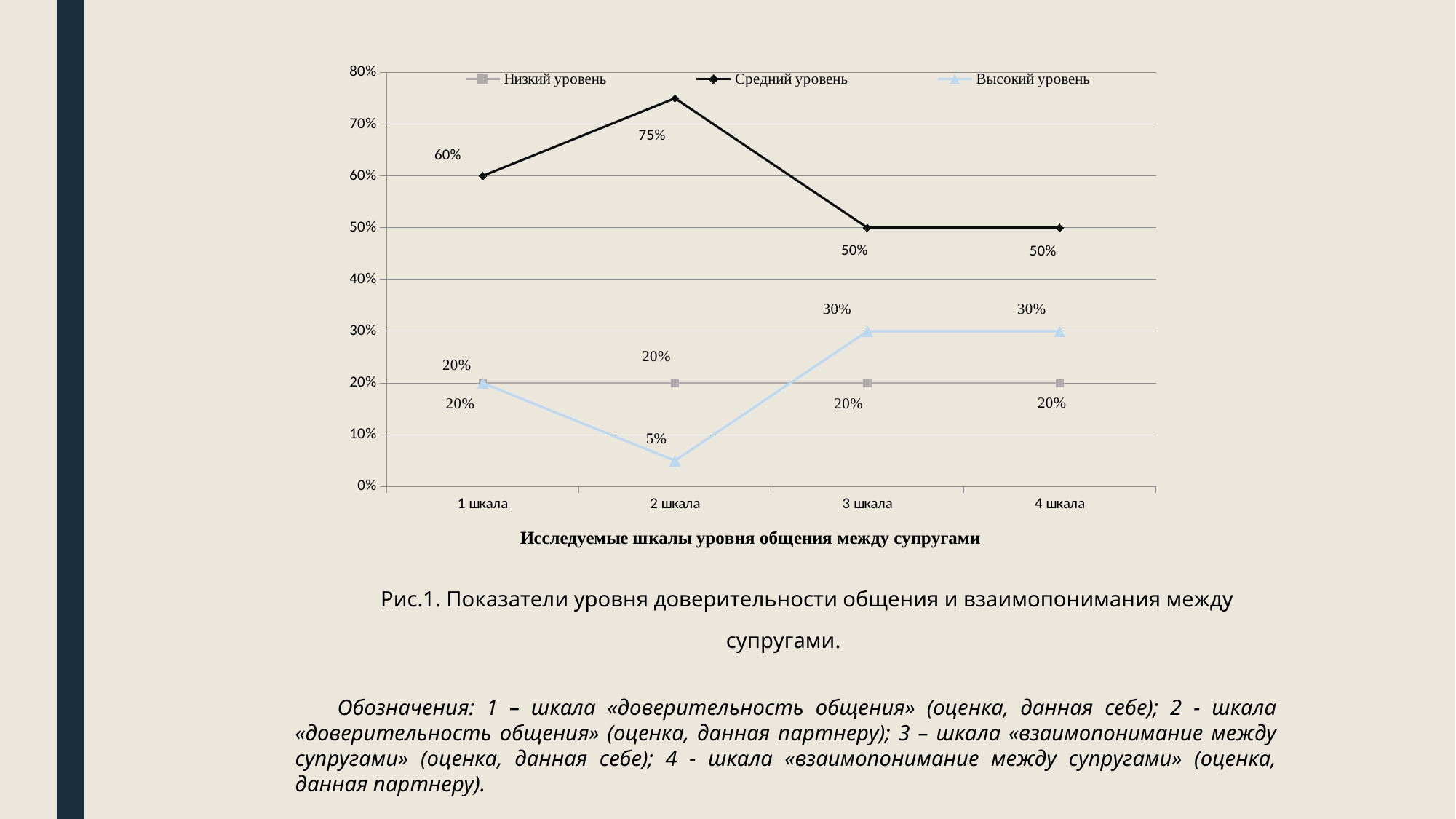
Which is larger for 4 шкала: Высокий уровень or Низкий уровень? Высокий уровень What is the value of Высокий уровень for 3 шкала? 30% What is the difference between Средний уровень for 2 шкала and for 3 шкала? 25% What is the value of Высокий уровень for 2 шкала? 5% What is the value of Средний уровень for 2 шкала? 75% What is the value of Средний уровень for 1 шкала? 60% What kind of chart is shown on the slide? line chart Does Средний уровень rise or fall from 2 шкала to 3 шкала? fall How many categories are shown on the x axis? 4 How many series does the legend list? 3 For which category is Средний уровень highest? 2 шкала For which category is Высокий уровень lowest? 2 шкала